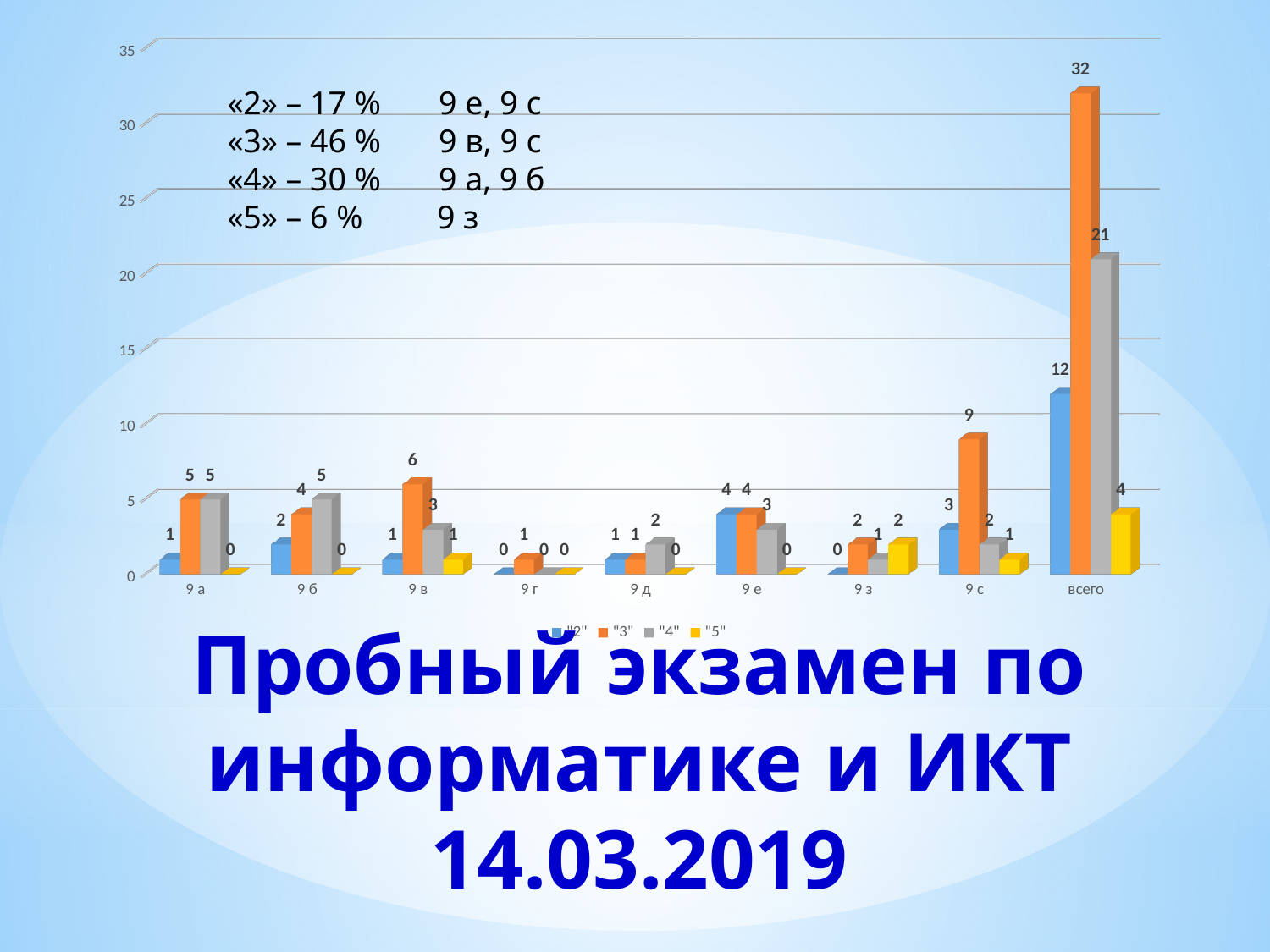
Which is larger for the category 9 б: the value of series "3" or the value of series "4"? "4" What is the value of series "4" for the category всего? 21 What is the total of the four series values for the category 9 в? 11 Among the class categories (excluding всего), which has the highest value for series "3"? 9 с How many series does the chart's legend list? 4 What is the value of series "3" for the category 9 с? 9 What is the difference between the series "3" value and the series "4" value for всего? 11 What is the value of series "3" for the category всего? 32 What is the value of series "2" for the category 9 е? 4 How many categories are shown along the x axis of the chart? 9 Which category has the highest value for series "3"? всего What type of chart is shown on the slide? bar chart